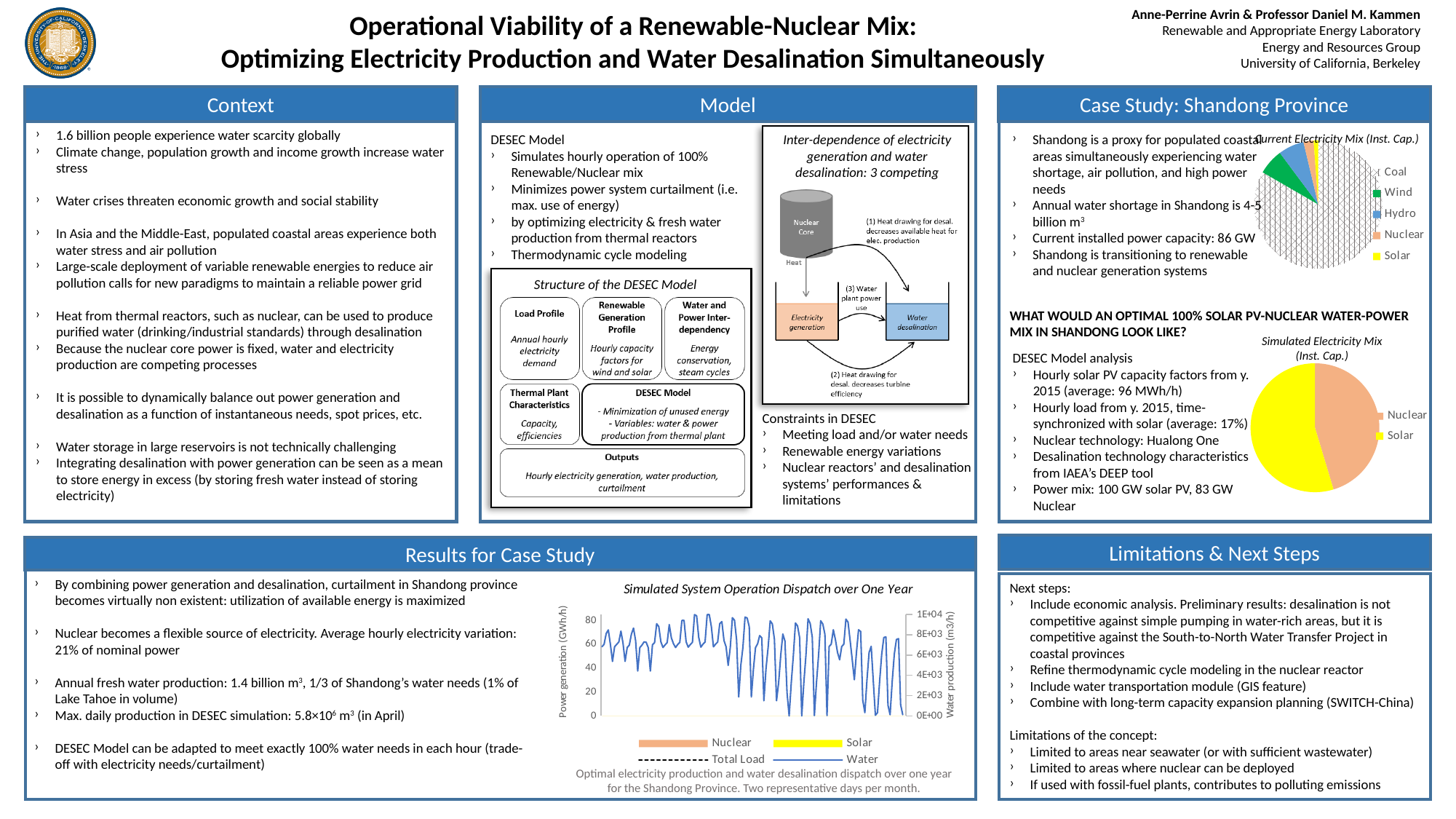
How many categories does the legend of the 'Current Electricity Mix (Inst. Cap.)' pie chart list? 5 What kind of chart is the 'Simulated Electricity Mix (Inst. Cap.)' chart? Pie chart What colour represents Solar in the 'Simulated Electricity Mix (Inst. Cap.)' pie chart? Yellow What kind of chart is the 'Current Electricity Mix (Inst. Cap.)' chart? Pie chart What kind of chart is the 'Simulated System Operation Dispatch over One Year' chart? Line chart How many series does the legend of the 'Simulated System Operation Dispatch over One Year' chart list? 4 In the 'Current Electricity Mix (Inst. Cap.)' pie chart, which slice is larger, Coal or Wind? Coal Which category has the largest slice in the 'Current Electricity Mix (Inst. Cap.)' pie chart? Coal Which category has the larger slice in the 'Simulated Electricity Mix (Inst. Cap.)' pie chart? Solar What is the highest tick value on the left vertical axis of the 'Simulated System Operation Dispatch over One Year' chart? 80 What is the label of the left vertical axis in the 'Simulated System Operation Dispatch over One Year' chart? Power generation (GWh/h) How many categories does the 'Simulated Electricity Mix (Inst. Cap.)' pie chart show? 2